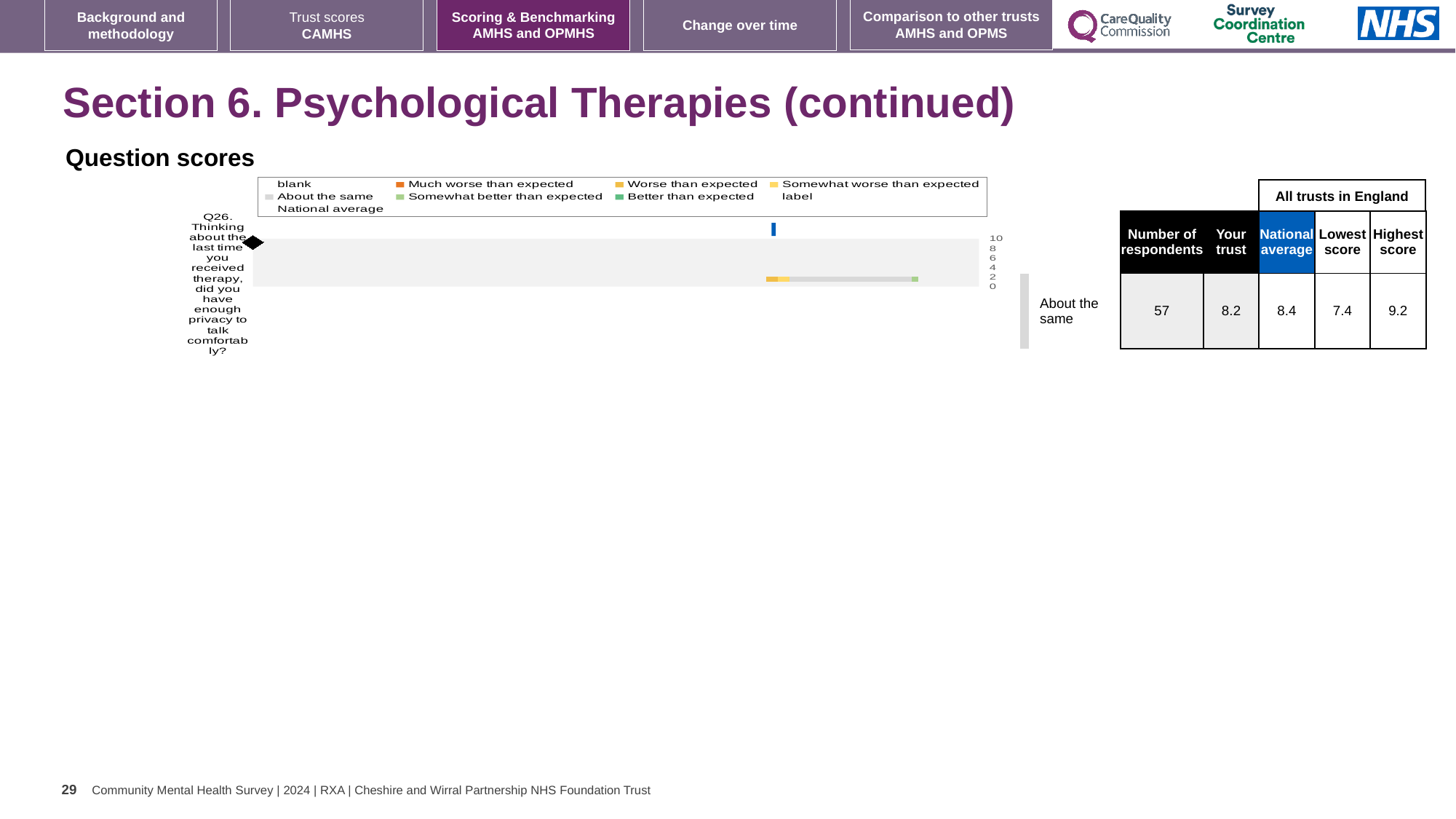
How many survey questions are plotted in the Question scores chart? 1 In the table beside the Question scores chart, what is the 'Your trust' score for Q26? 8.2 In the table beside the Question scores chart, what is the national average for Q26? 8.4 For Q26, what is the difference between the highest score and the lowest score among all trusts in England? 1.8 For Q26, which is larger: the 'Your trust' score or the national average? National average How many entries does the legend of the Question scores chart list? 9 What is the highest tick value shown on the axis of the Question scores chart? 10 What kind of chart is shown under 'Question scores'? bar chart In the table beside the Question scores chart, what is the number of respondents for Q26? 57 In the table beside the Question scores chart, what is the highest score among all trusts in England for Q26? 9.2 In the table beside the Question scores chart, what is the lowest score among all trusts in England for Q26? 7.4 What benchmark category is shown next to the Question scores chart for Q26? About the same